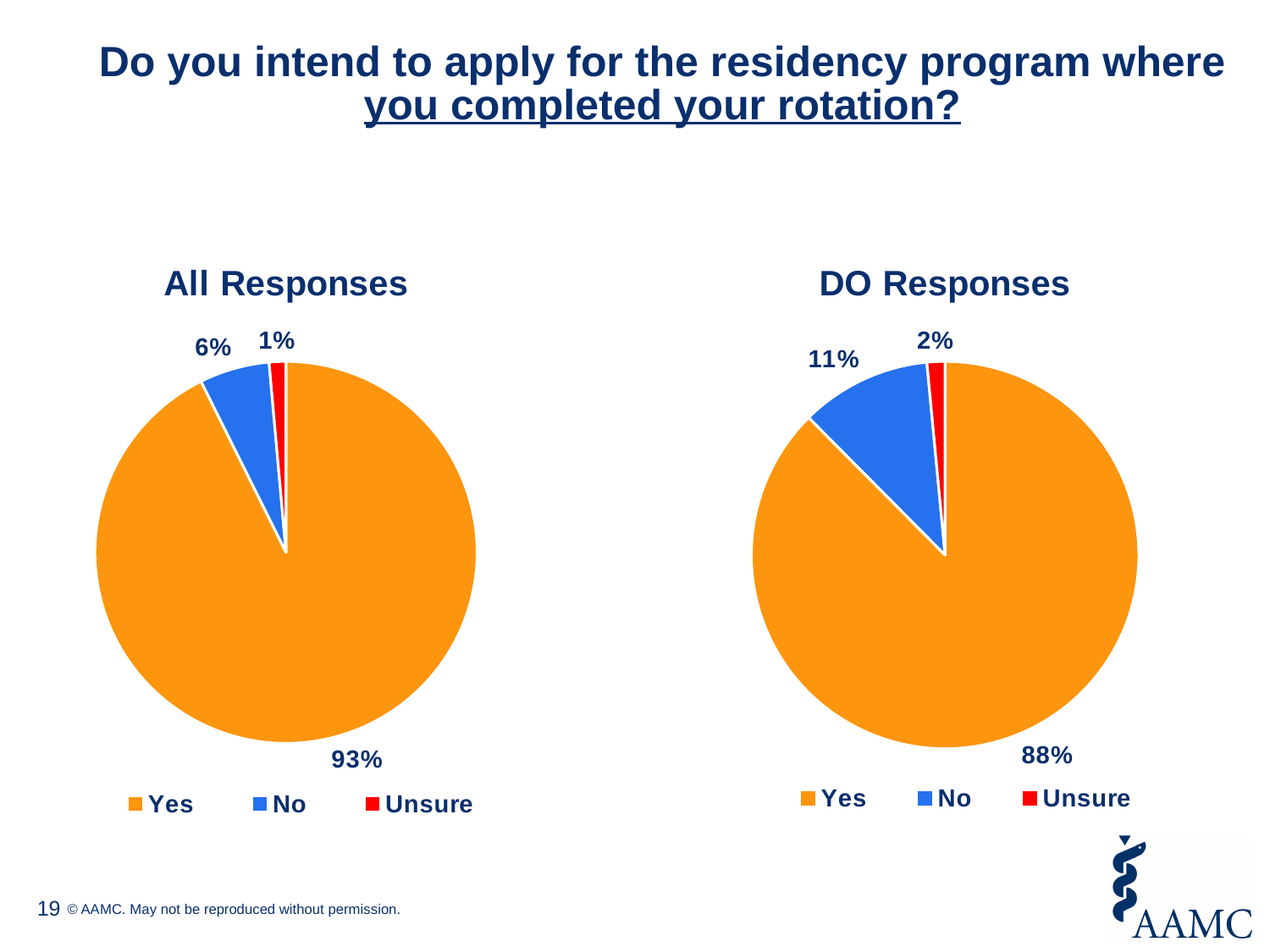
In the "DO Responses" chart, what share of responses is "Yes"? 88% In the "DO Responses" chart, which category has the largest slice? Yes Which chart has the larger "No" share, "All Responses" or "DO Responses"? DO Responses What is the difference between the "Yes" share in the "All Responses" chart and the "Yes" share in the "DO Responses" chart? 5% In the "All Responses" chart, what share of responses is "Unsure"? 1% In the "All Responses" chart, what share of responses is "Yes"? 93% In the "DO Responses" chart, what share of responses is "Unsure"? 2% What kind of chart is the "All Responses" chart? Pie chart In the "All Responses" chart, which category has the smallest slice? Unsure How many categories does the legend of the "DO Responses" chart list? 3 In the "DO Responses" chart, what share of responses is "No"? 11% In the "All Responses" chart, what share of responses is "No"? 6%